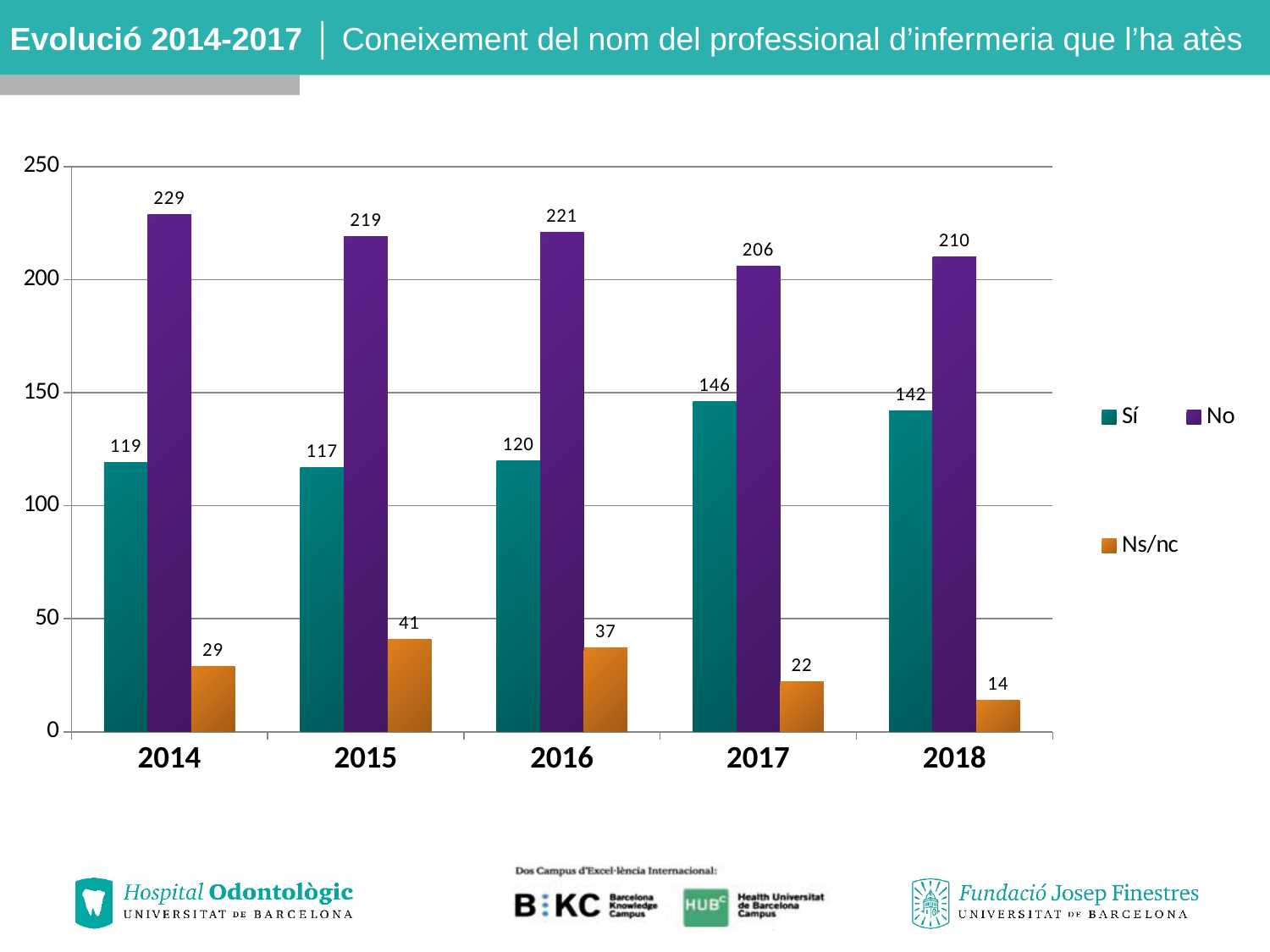
How many years are shown on the x axis? 5 In which year is the "Ns/nc" value lowest? 2018 What is the total of the three values for 2017? 374 What kind of chart is shown on the slide? Bar chart How many series does the legend list? 3 Which is larger in 2015: the "Sí" value or the "No" value? No What is the value for "Sí" in 2017? 146 In which year is the "No" value highest? 2014 What is the value for "No" in 2014? 229 What is the difference between the "No" and "Sí" values in 2016? 101 What is the value for "Ns/nc" in 2018? 14 Does the "No" value rise or fall from 2014 to 2017? Fall